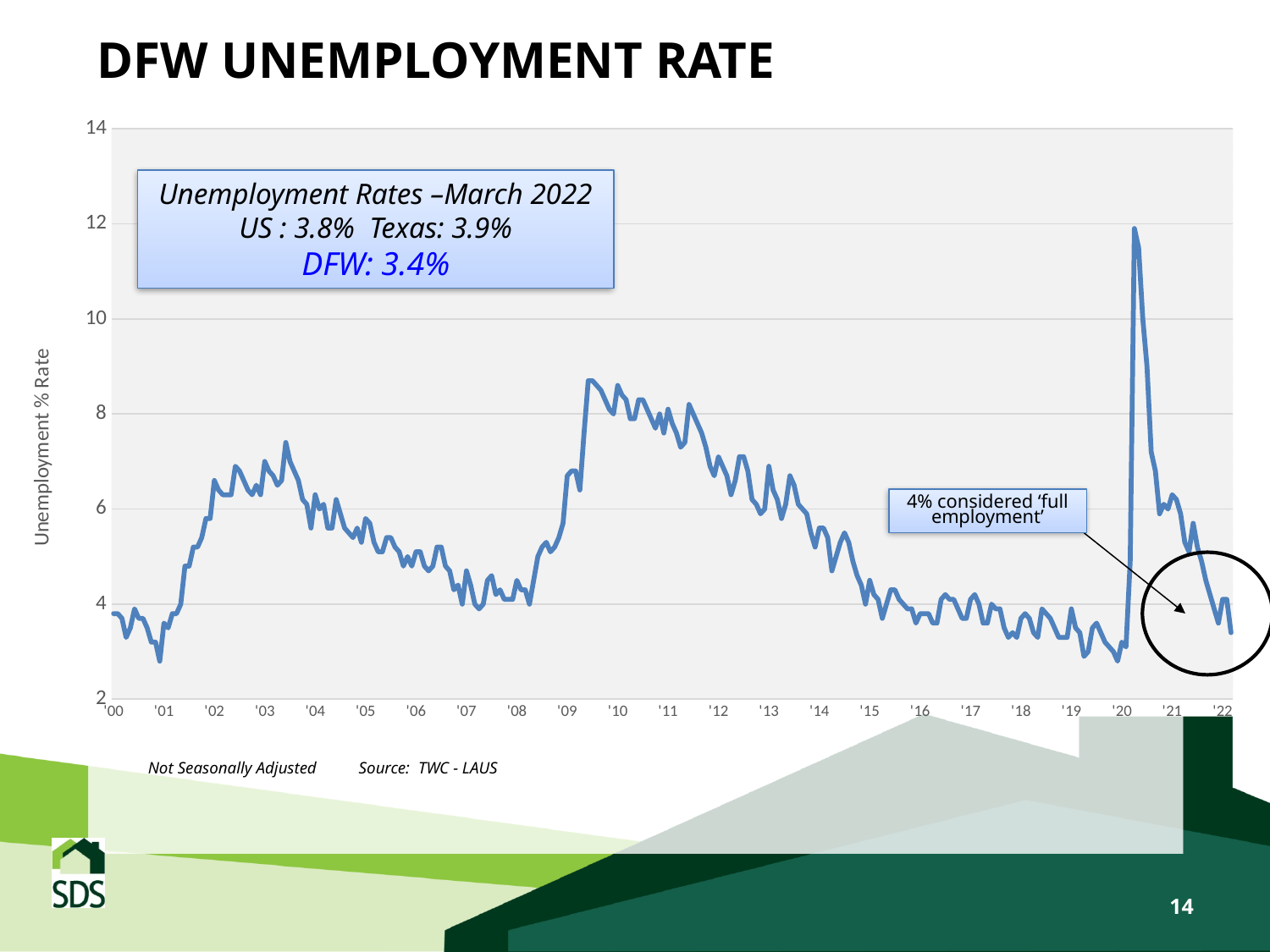
In which year does the DFW unemployment rate reach its highest peak? '20 Between '10 and '19, does the DFW unemployment rate generally rise or fall? fall What was the DFW unemployment rate in March 2022? 3.4% Is the peak DFW unemployment rate in 2020 greater or less than 10? greater How much higher was the Texas unemployment rate than the DFW rate in March 2022? 0.5% What kind of chart is shown on the slide? line chart In March 2022, which had the higher unemployment rate, the US or Texas? Texas What was the Texas unemployment rate in March 2022? 3.9% Is the lowest DFW unemployment rate around '01 greater or less than 4? less How many year labels are shown on the x axis? 23 What was the US unemployment rate in March 2022? 3.8% According to the annotation on the chart, what unemployment rate is considered 'full employment'? 4%